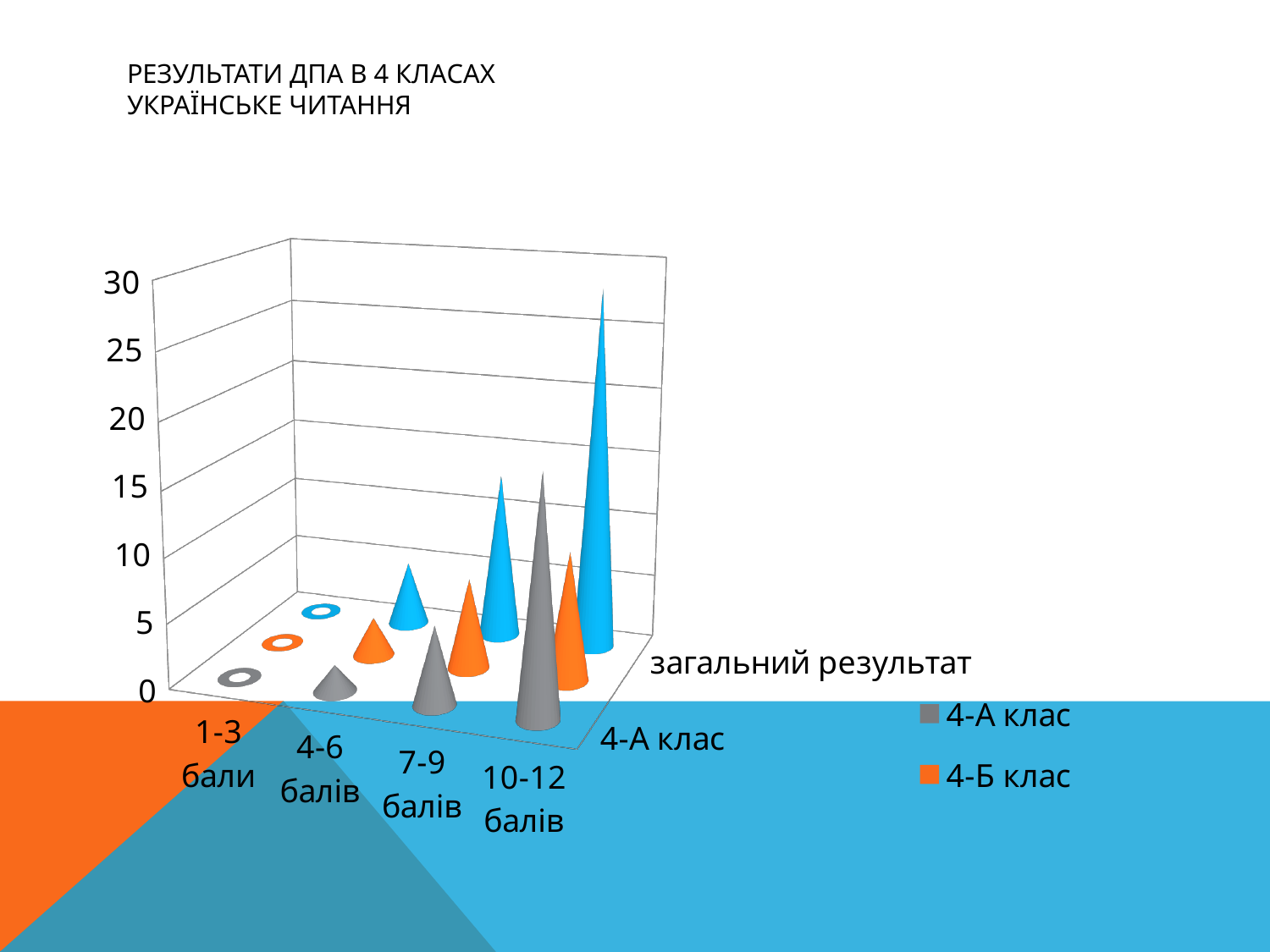
Which score category has the lowest value for the 4-А клас series? 1-3 бали Which score category has the highest value for the загальний результат series? 10-12 балів Is the value for 4-А клас in the 10-12 балів category greater or less than 5? greater Is the value for загальний результат in the 4-6 балів category greater or less than 10? less How many score categories are shown on the x axis? 4 Is the value for 4-Б клас in the 10-12 балів category greater or less than 15? less How many series does the legend list? 3 Do the values for загальний результат rise or fall from 1-3 бали to 10-12 балів? rise In the 4-6 балів category, which is larger: 4-А клас or 4-Б клас? 4-Б клас In the 10-12 балів category, which is larger: 4-А клас or 4-Б клас? 4-А клас What kind of chart is shown on the slide? bar chart